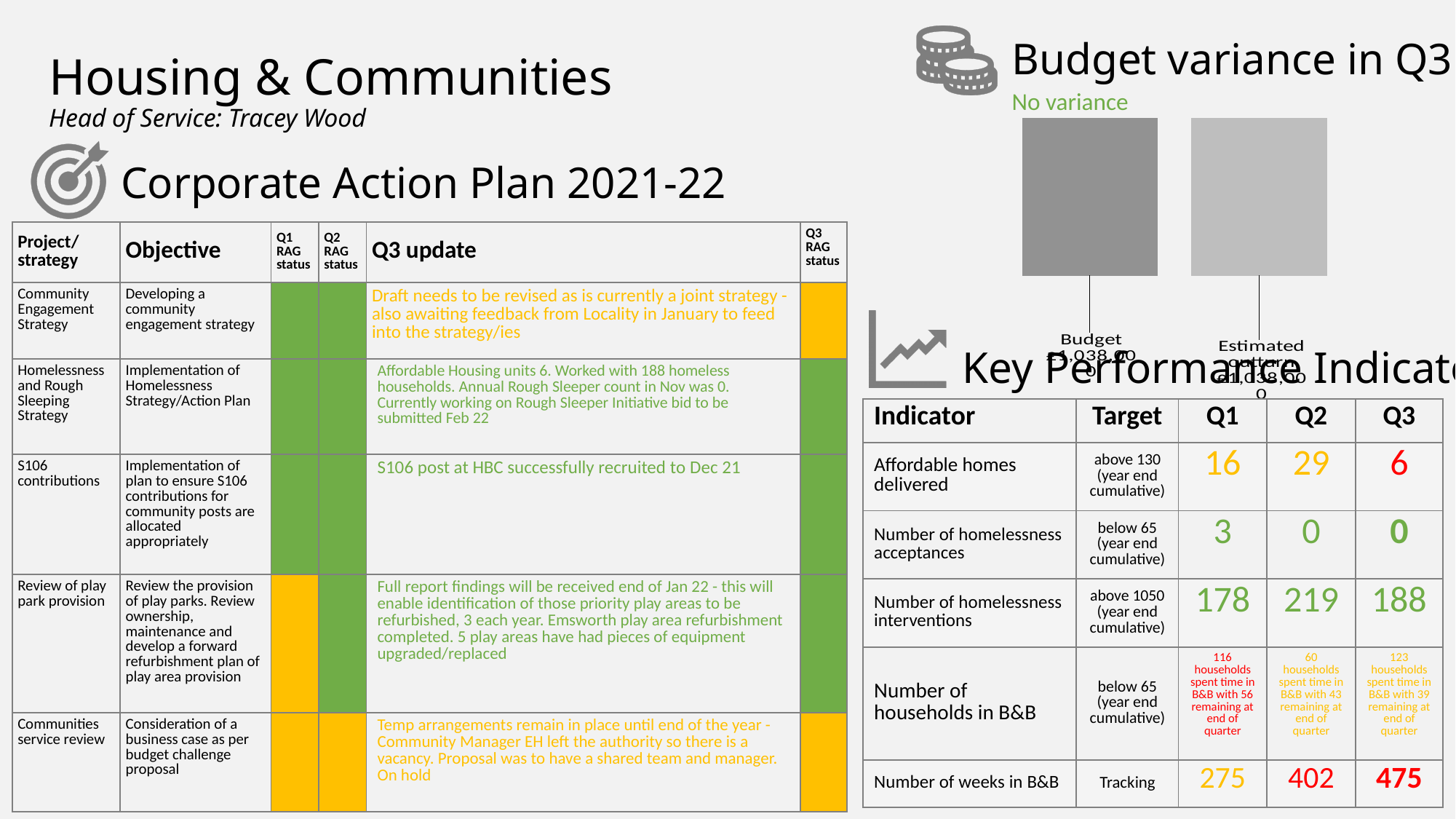
What does the green text just below the 'Budget variance in Q3' title say? No variance In the 'Budget variance in Q3' chart, are the Budget bar and the Estimated outturn bar the same height? yes In the 'Budget variance in Q3' chart, is the Estimated outturn bar taller than the Budget bar? no What is the title of the chart in the top right of the slide? Budget variance in Q3 What kind of chart is shown under the 'Budget variance in Q3' heading? bar chart How many bars does the 'Budget variance in Q3' chart show? 2